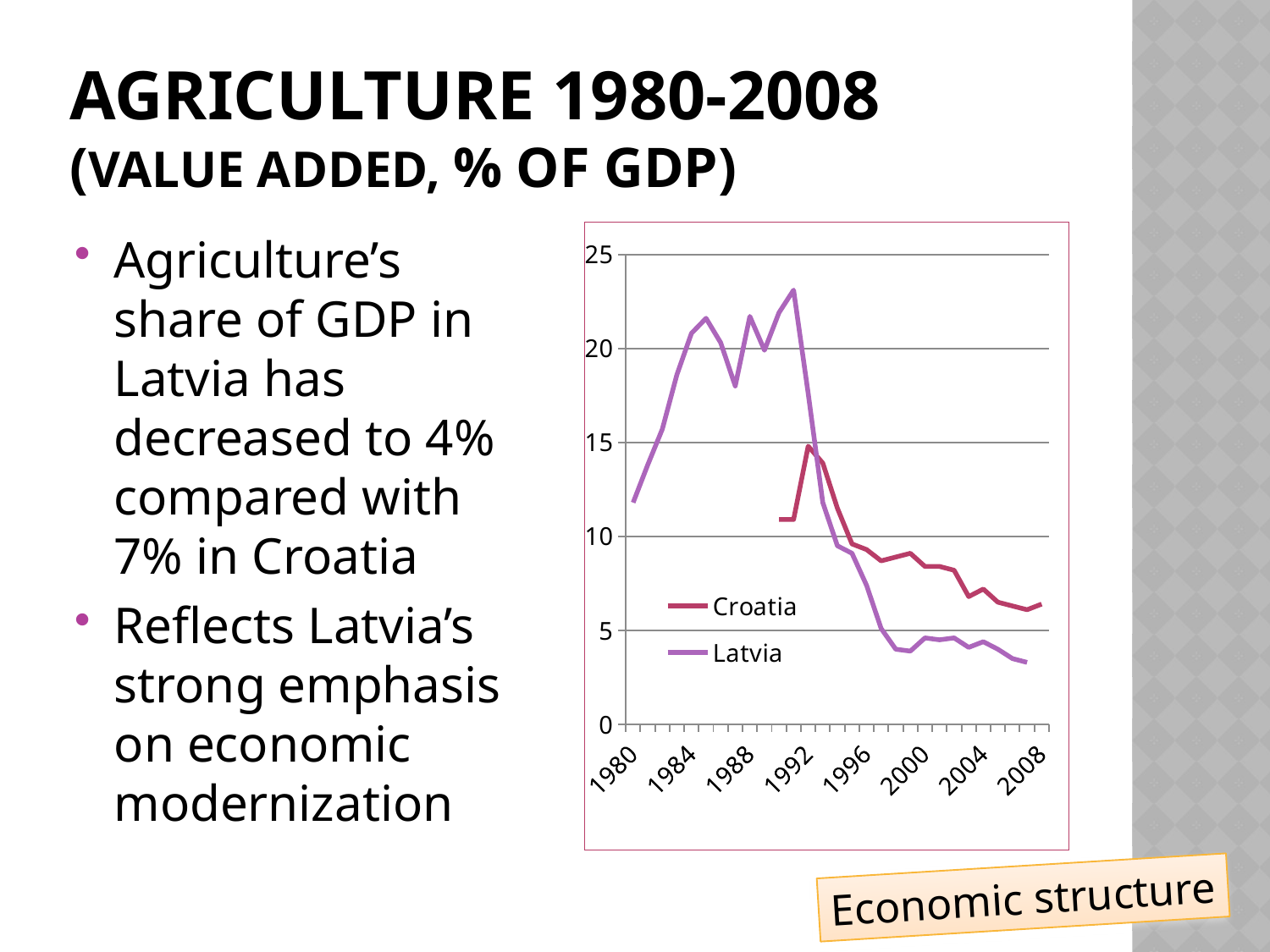
Is the peak value for Latvia greater or less than 20? greater Which two countries are shown in the chart's legend? Croatia and Latvia Is the value for Latvia in 1980 greater or less than 10? greater How many series does the chart's legend list? 2 Is the value for Croatia in 2008 greater or less than 5? greater What kind of chart is shown on the slide? line chart Which series reaches the highest value anywhere on the chart? Latvia Which series is drawn in purple? Latvia